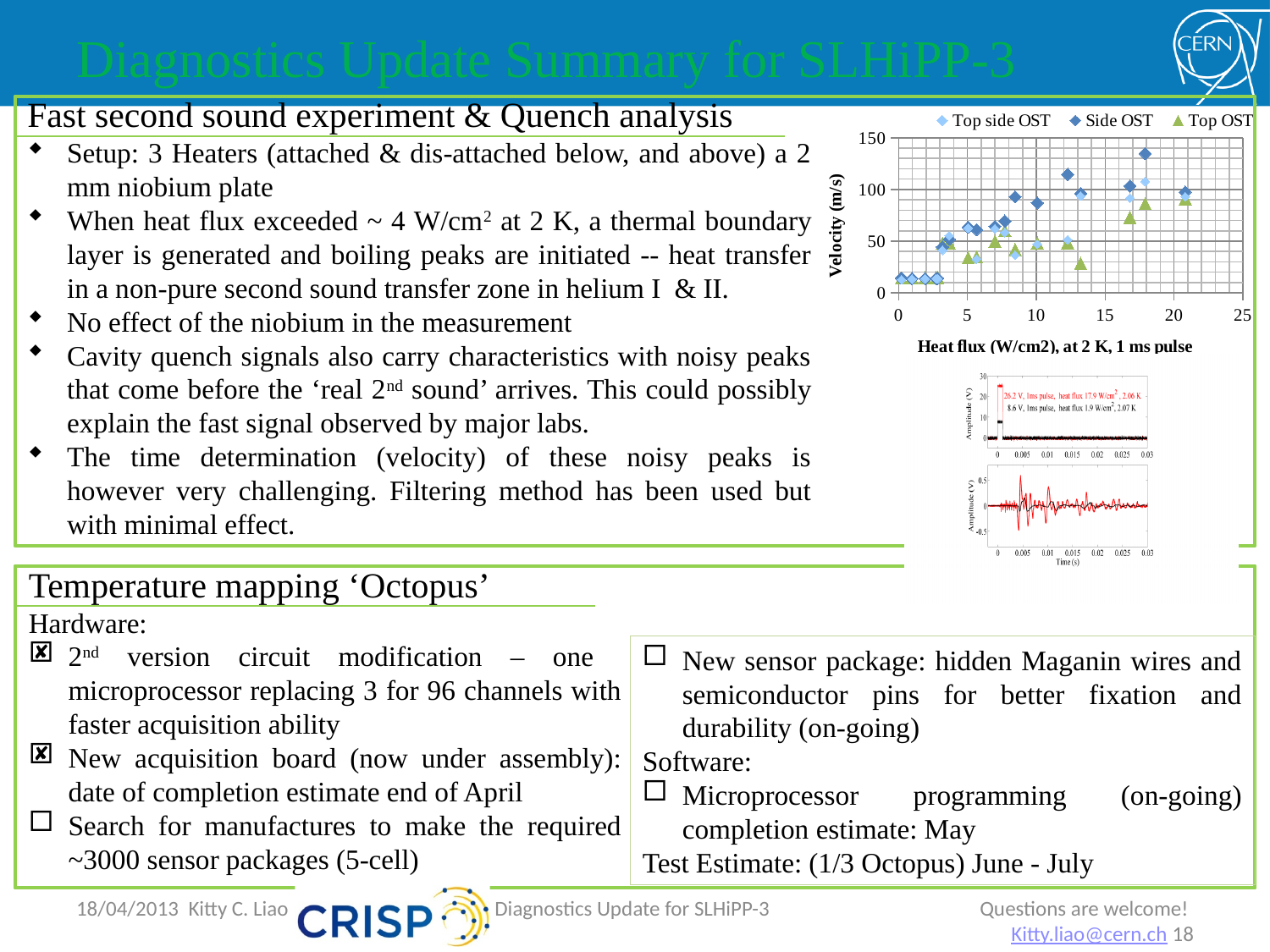
In the scatter chart, is the highest Side OST velocity value greater or less than 100? greater In the scatter chart, which series reaches the highest velocity value? Side OST In the scatter chart, are the velocity values at heat flux near 1 W/cm2 greater or less than 50? less In the scatter chart, do the velocity values generally rise or fall as heat flux increases? rise How many series does the legend of the scatter chart list? 3 What is the title of the horizontal axis of the scatter chart? Heat flux (W/cm2), at 2 K, 1 ms pulse What kind of chart is the chart in the upper right of the slide? scatter chart What is the title of the vertical axis of the scatter chart? Velocity (m/s) In the scatter chart, is the Top OST velocity value at heat flux near 13 W/cm2 greater or less than 50? less What is the maximum value shown on the vertical axis of the scatter chart? 150 In the scatter chart, at heat flux near 18 W/cm2, which series has the larger velocity, Side OST or Top OST? Side OST